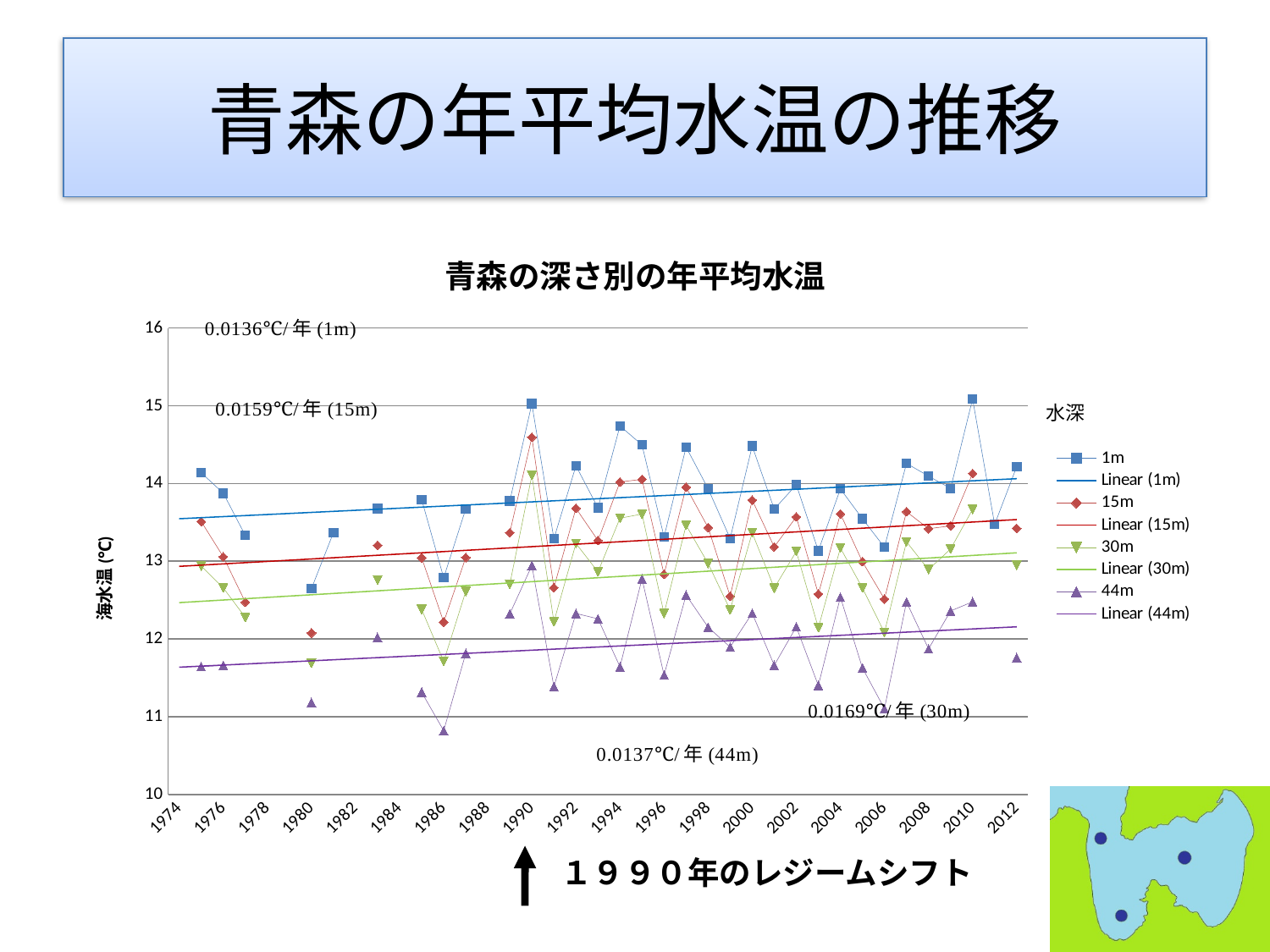
What kind of chart is shown on the slide? line chart What is the title of the chart? 青森の深さ別の年平均水温 What is the trend slope printed on the chart for the 44m series? 0.0137℃/年 What is the trend slope printed on the chart for the 15m series? 0.0159℃/年 Do the linear trend lines rise or fall from 1974 to 2012? rise What is the trend slope printed on the chart for the 1m series? 0.0136℃/年 How many entries does the chart's legend list? 8 Is the value for the 1m series in 1986 greater or less than 13? less What is the trend slope printed on the chart for the 30m series? 0.0169℃/年 Is the value for the 44m series in 1986 greater or less than 11? less In 1990, which series has the higher value, 1m or 44m? 1m Is the value for the 15m series in 1990 greater or less than 14? greater